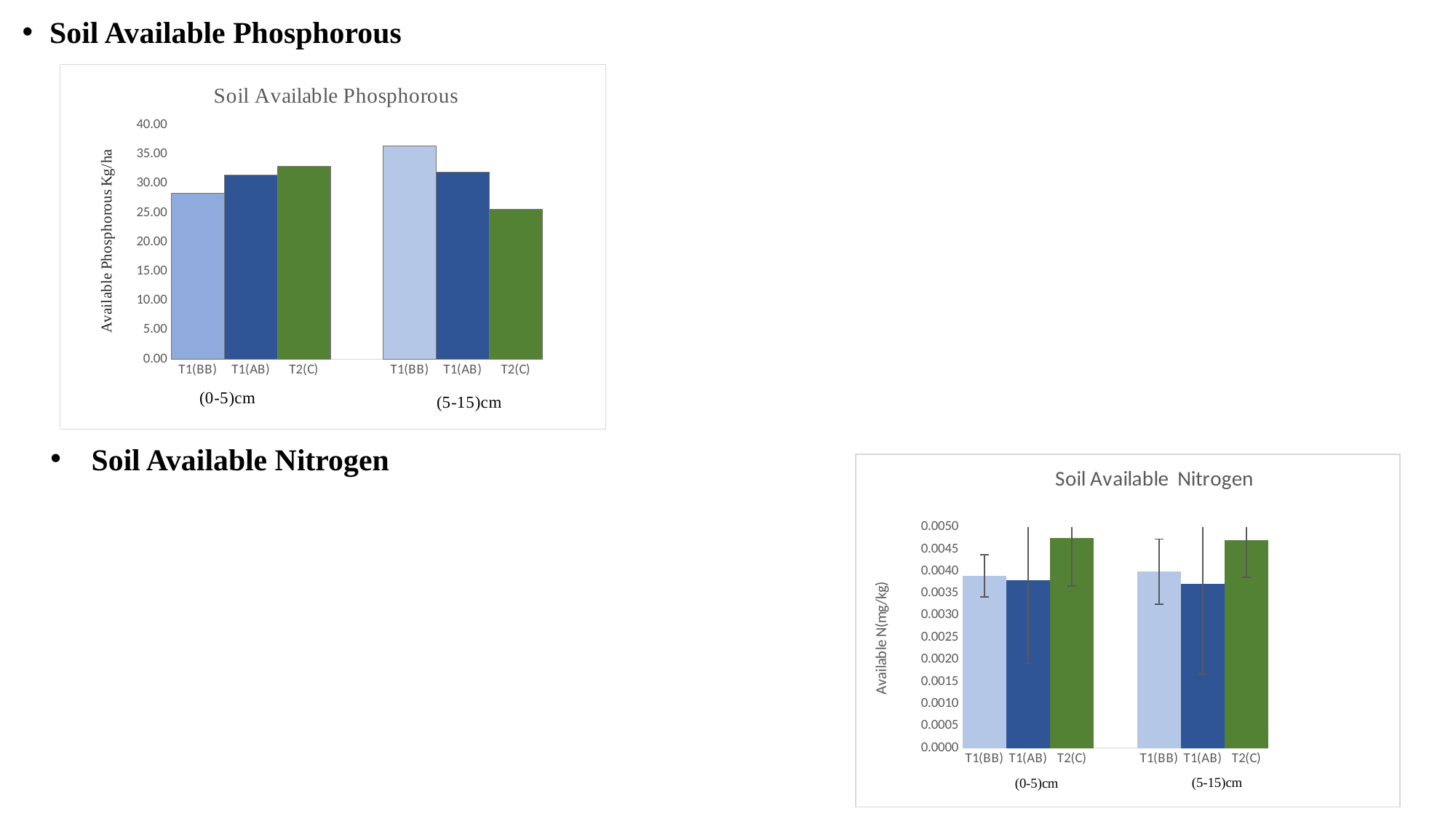
In the Soil Available Phosphorous chart, which is larger at (0-5)cm: T1(BB) or T2(C)? T2(C) In the Soil Available Nitrogen chart, is the value for T2(C) at (5-15)cm greater or less than 0.0045? greater In the Soil Available Phosphorous chart, how many bars are plotted in total? 6 In the Soil Available Phosphorous chart, what kind of chart is shown? bar chart In the Soil Available Phosphorous chart, is the value for T1(BB) at (0-5)cm greater or less than 30.00? less In the Soil Available Phosphorous chart, which bar is the lowest? T2(C) at (5-15)cm In the Soil Available Phosphorous chart, what is the y-axis label? Available Phosphorous Kg/ha In the Soil Available Nitrogen chart, which is larger at (5-15)cm: T1(AB) or T2(C)? T2(C) In the Soil Available Phosphorous chart, is the value for T1(BB) at (5-15)cm greater or less than 35.00? greater In the Soil Available Nitrogen chart, what is the y-axis label? Available N(mg/kg) In the Soil Available Phosphorous chart, which bar is the highest? T1(BB) at (5-15)cm